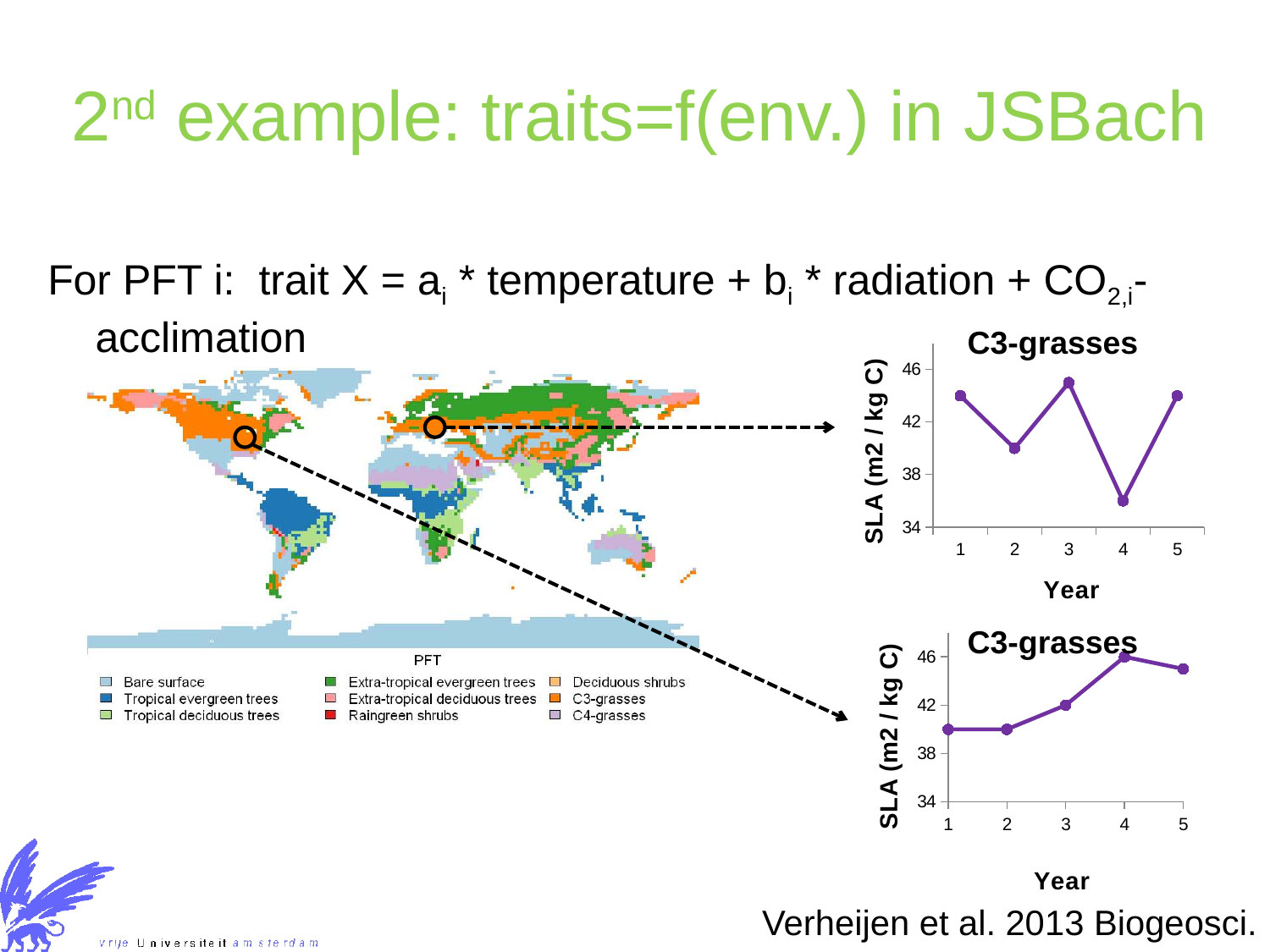
What is the y-axis label of the lower C3-grasses chart? SLA (m2 / kg C) In the upper C3-grasses chart, which is larger, the SLA value for year 2 or for year 3? year 3 In the upper C3-grasses chart, how many years are plotted along the x axis? 5 In the lower C3-grasses chart, what is the SLA value for year 4? 46 In the upper C3-grasses chart, is the SLA value for year 3 greater or less than 42? greater In the upper C3-grasses chart, is the SLA value for year 4 greater or less than 38? less In the upper C3-grasses chart, which year has the lowest SLA value? 4 In the lower C3-grasses chart, is the SLA value for year 1 greater or less than 42? less In the lower C3-grasses chart, do the SLA values generally rise or fall from year 1 to year 5? rise What kind of chart is the upper C3-grasses chart on the right of the slide? line chart In the lower C3-grasses chart, which year has the highest SLA value? 4 In the upper C3-grasses chart, which year has the highest SLA value? 3